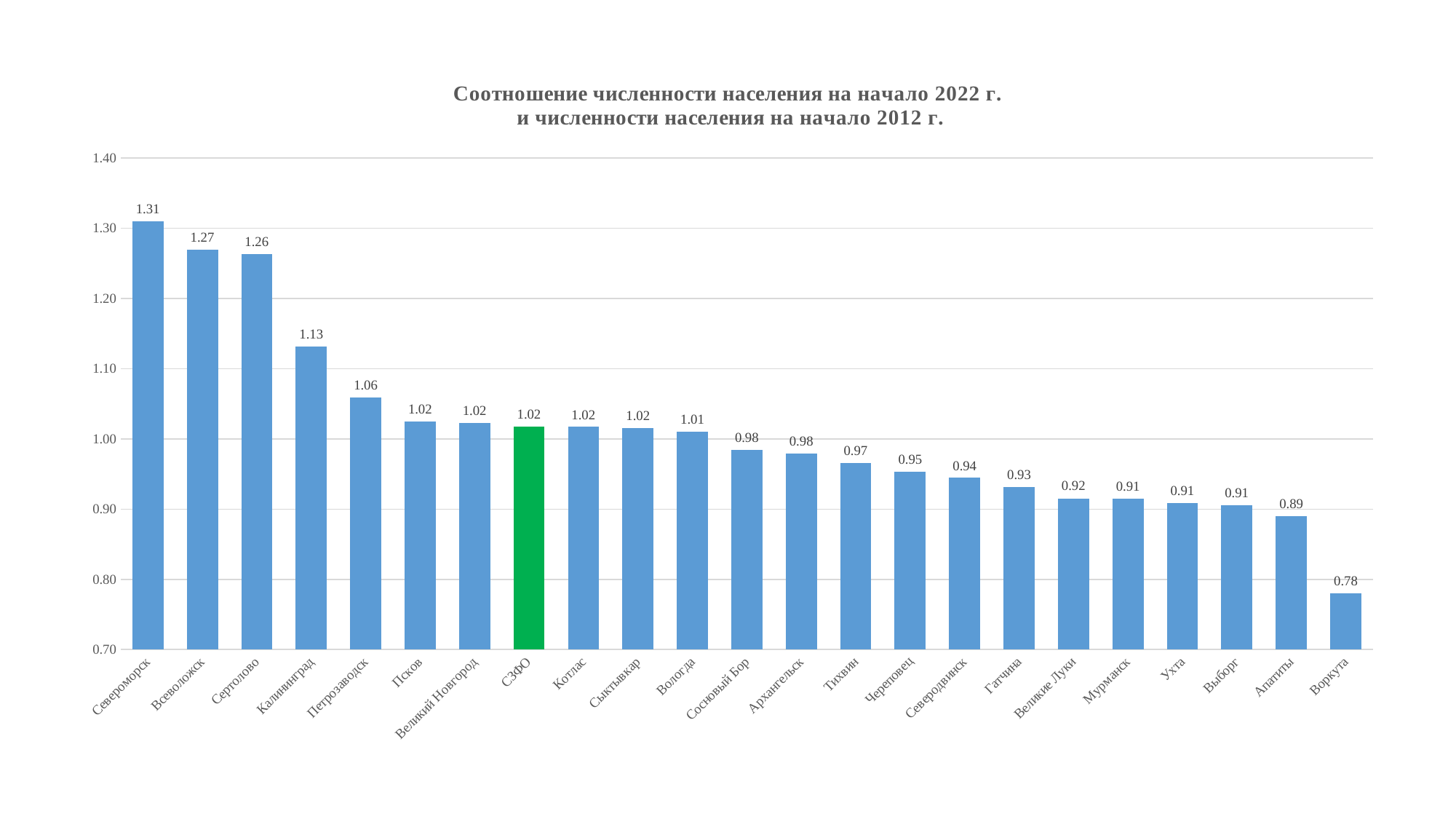
What is the difference between the values for Североморск and Воркута? 0.53 Which is larger, the value for Всеволожск or the value for Петрозаводск? Всеволожск What is the value for Североморск? 1.31 What is the value for Воркута? 0.78 What kind of chart is this? bar chart What is the value for СЗФО? 1.02 Which bar is coloured green instead of blue? СЗФО Which category has the highest value? Североморск What is the value for Калининград? 1.13 Is the value for Апатиты greater or less than 0.90? less How many categories are shown on the x axis? 23 Which category has the lowest value? Воркута